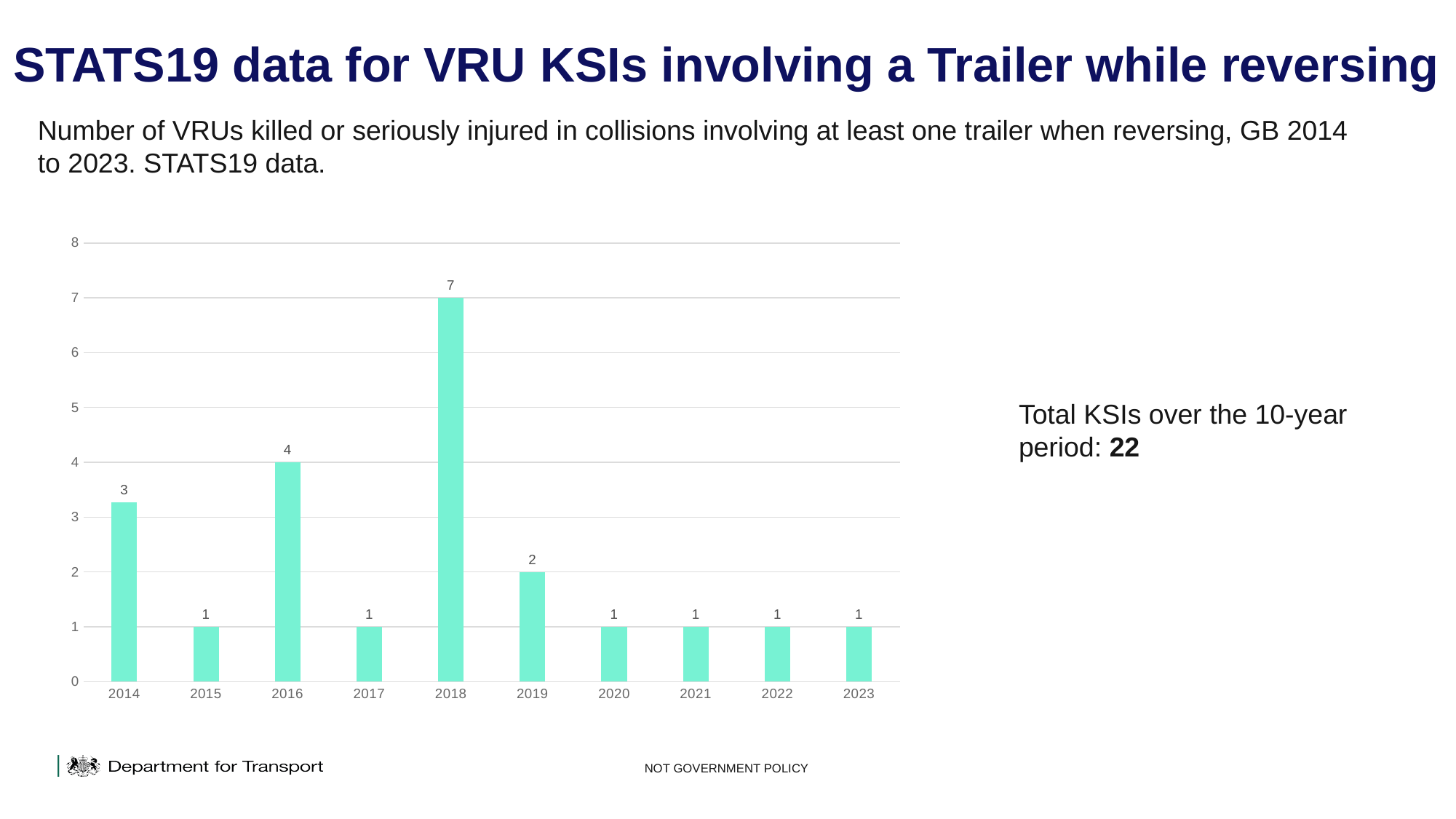
How many years have a value of 1 VRU KSI? 6 How many years are shown on the x axis of the chart? 10 Which year has the highest number of VRU KSIs? 2018 Is the value for 2018 greater or less than 5? greater What is the number of VRU KSIs in 2019? 2 What is the highest value shown on the y axis of the chart? 8 What kind of chart is shown on the slide? bar chart What is the number of VRU KSIs in 2018? 7 What is the total number of KSIs over the 10-year period stated on the slide? 22 What is the number of VRU KSIs in 2014? 3 Which year has more VRU KSIs, 2014 or 2016? 2016 What is the difference between the number of VRU KSIs in 2018 and in 2016? 3